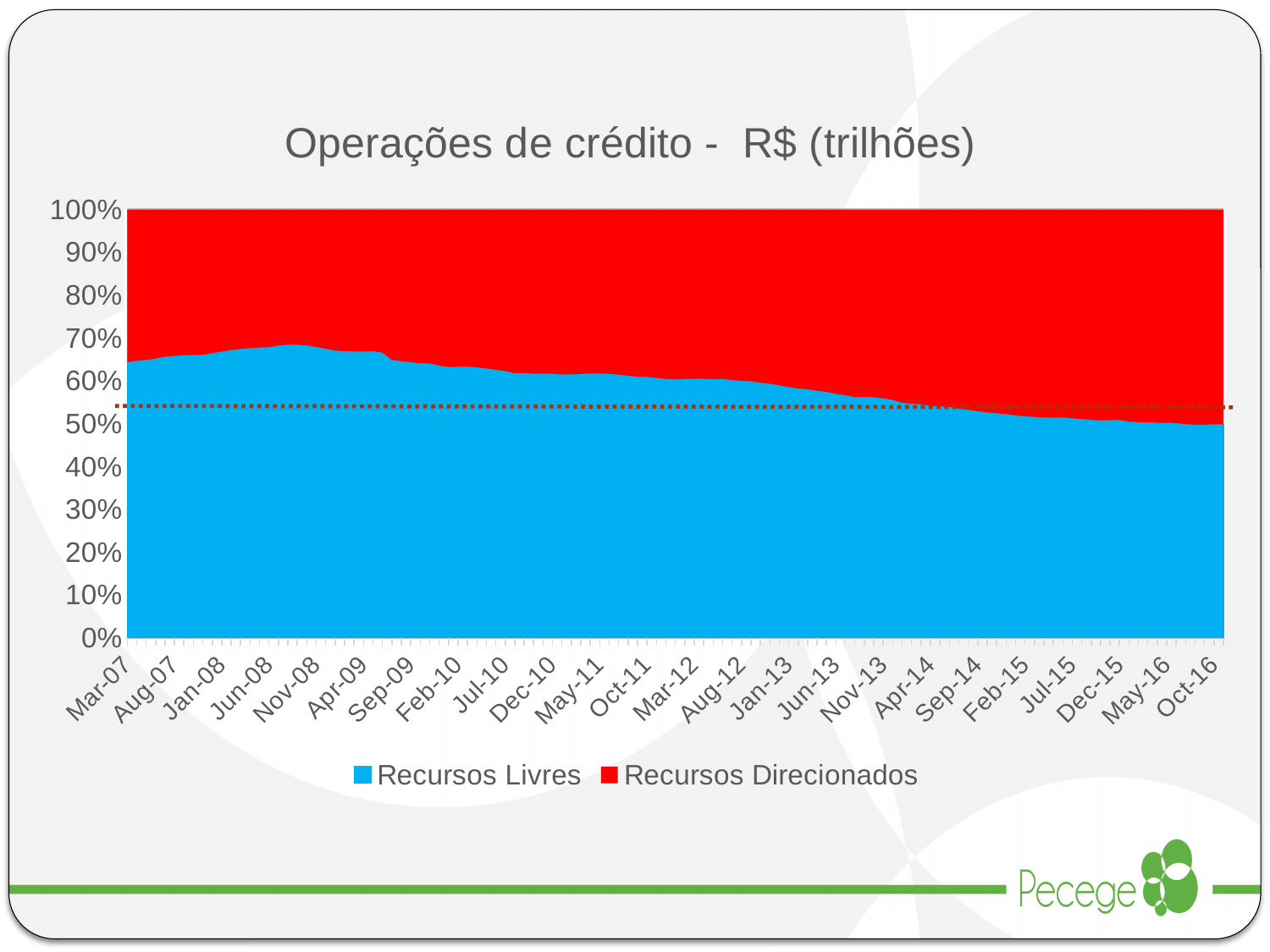
Which colour represents Recursos Direcionados in the chart? Red What is the highest value shown on the vertical axis? 100% Is the share of Recursos Direcionados at Oct-16 greater or less than 40%? greater Is the share of Recursos Livres at Mar-07 greater or less than 60%? greater Is the share of Recursos Livres at Nov-08 greater or less than 60%? greater Does the share of Recursos Livres rise or fall from Nov-08 to Oct-16? Fall At Mar-07, which series has the larger share, Recursos Livres or Recursos Direcionados? Recursos Livres What is the title of the chart? Operações de crédito - R$ (trilhões) Does the share of Recursos Direcionados rise or fall from Nov-08 to Oct-16? Rise What kind of chart is shown on the slide? Stacked area chart How many series does the legend list? 2